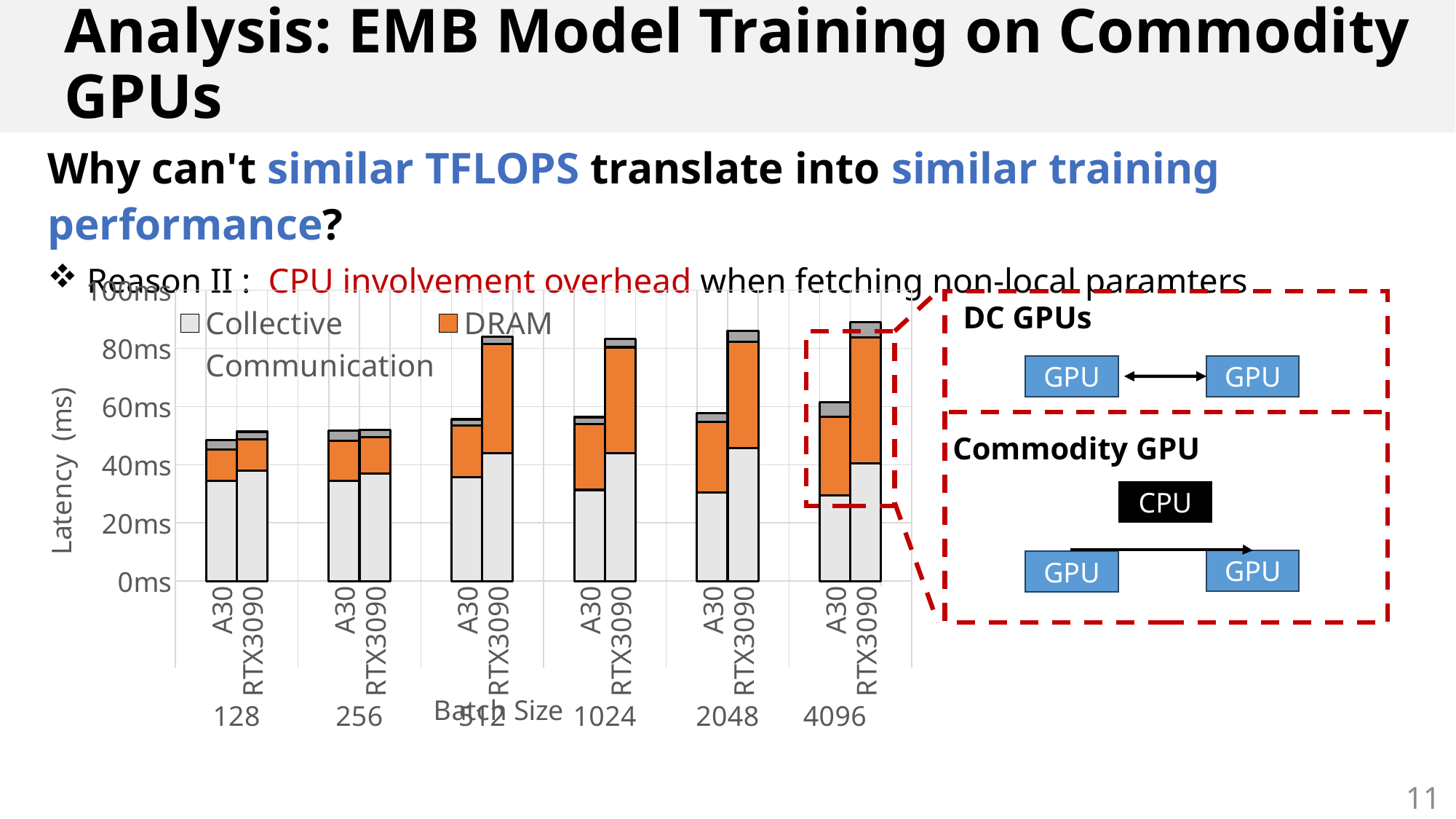
Which bar has the highest total latency in the chart? RTX3090 at batch size 4096 Which colour represents the DRAM series in the chart? orange How many batch sizes are shown along the x axis of the chart? 6 Is the total latency for A30 at batch size 128 greater or less than 60ms? less Is the total latency for RTX3090 at batch size 4096 greater or less than 80ms? greater What kind of chart is shown on the slide? stacked bar chart Is the total latency for A30 at batch size 4096 greater or less than 80ms? less How many bars are plotted in the chart in total? 12 How many series does the chart's legend list? 2 At batch size 512, which has the larger total latency, A30 or RTX3090? RTX3090 What is the label of the chart's y axis? Latency (ms)